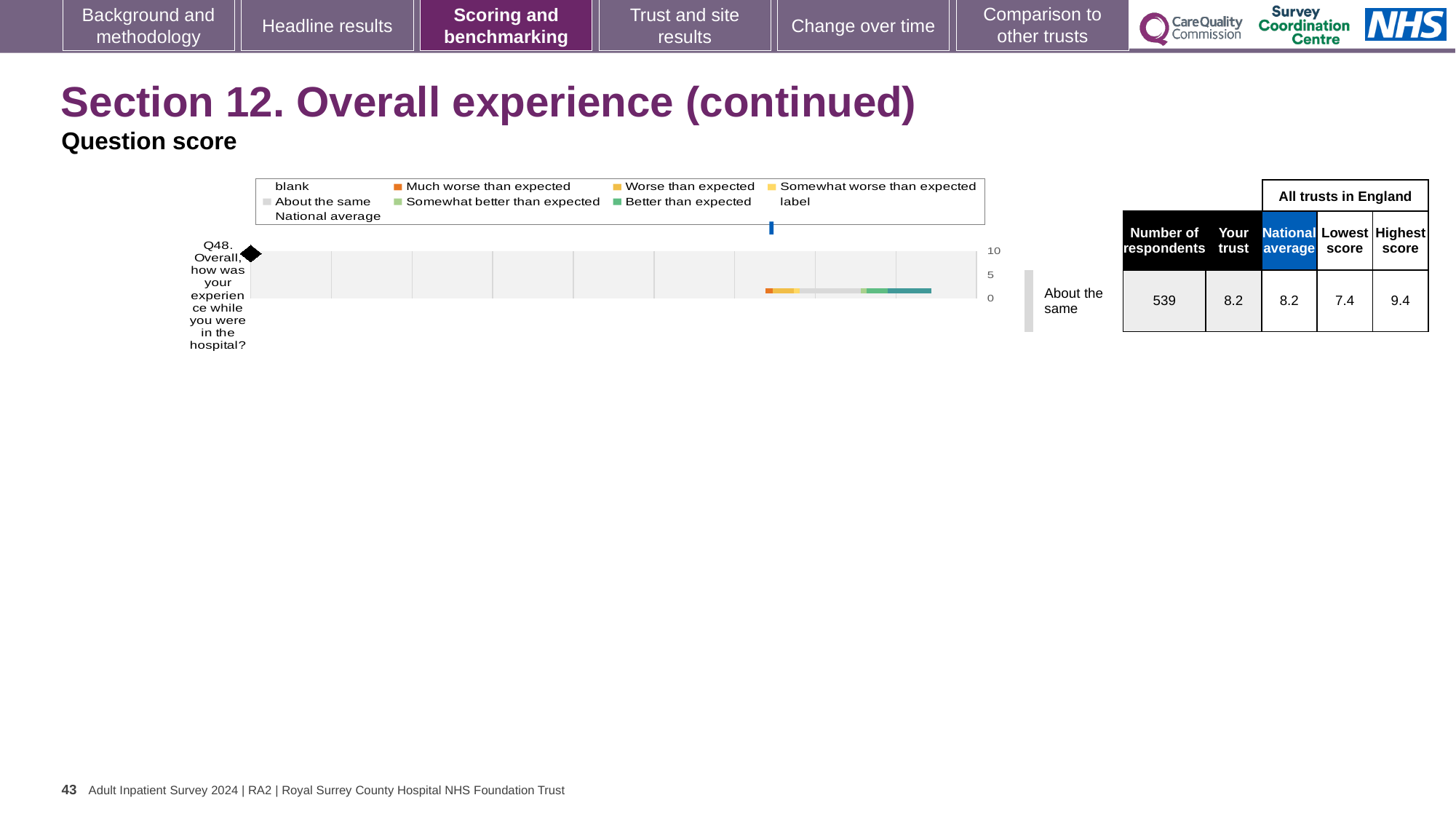
What is the lowest score among all trusts in England for Q48? 7.4 How many respondents answered Q48? 539 What is the highest score among all trusts in England for Q48? 9.4 What is the 'Your trust' score for Q48 (Overall, how was your experience while you were in the hospital?)? 8.2 Which benchmark category is the trust's Q48 result placed in? About the same How many survey questions are plotted in the chart? 1 Is the trust's score for Q48 higher than, lower than, or the same as the national average? the same What is the national average score for Q48? 8.2 What is the maximum value shown on the chart's score axis? 10 What kind of chart is shown on the slide? bar chart What is the difference between the highest and lowest trust scores for Q48? 2.0